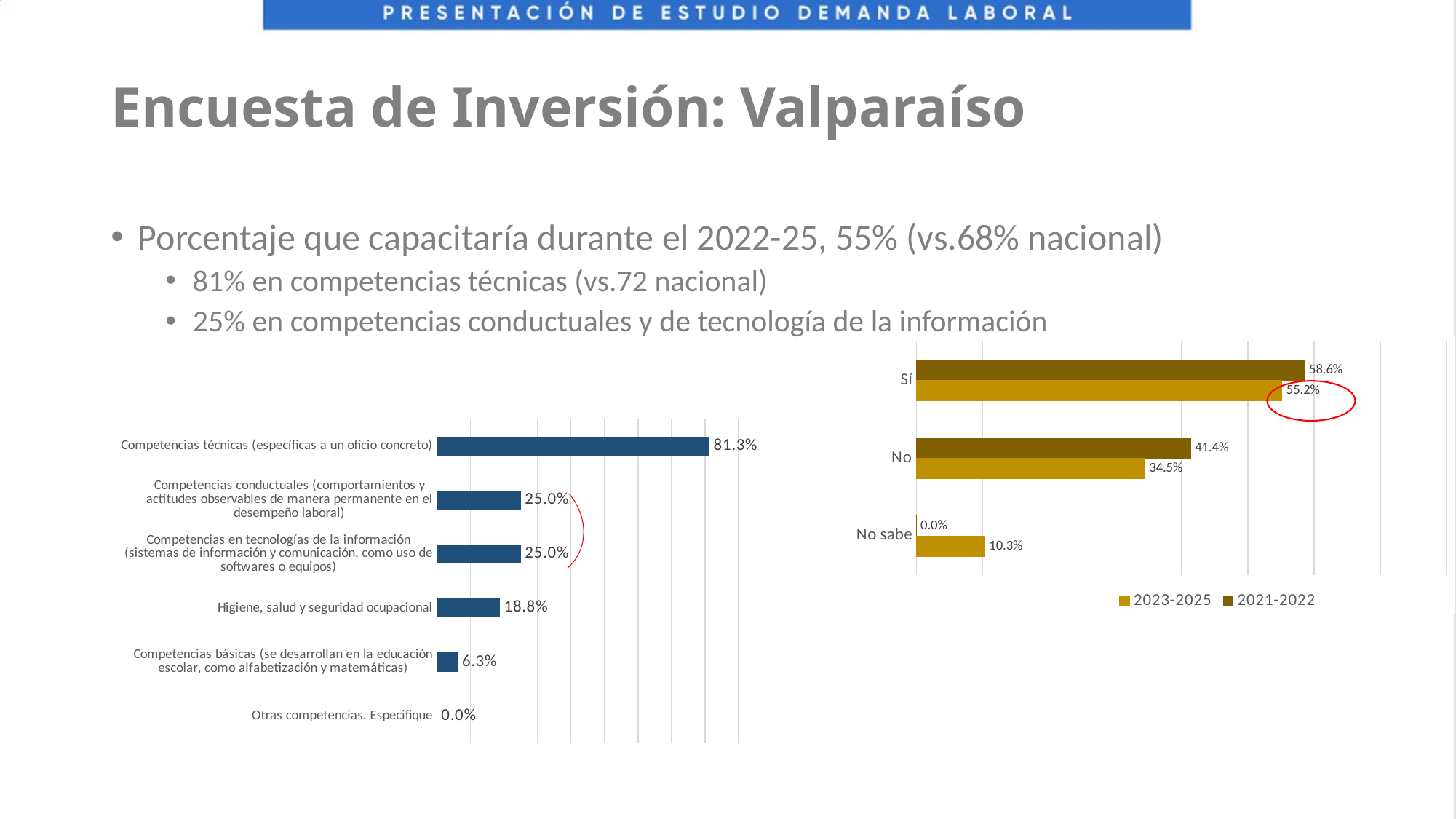
In the left chart, how many categories are shown? 6 In the right chart, which is larger for Sí: 2023-2025 or 2021-2022? 2021-2022 In the left chart, what is the difference between Competencias técnicas and Competencias básicas? 75.0% In the right chart, what is the value for Sí in the 2021-2022 series? 58.6% In the right chart, what is the value for No sabe in the 2023-2025 series? 10.3% What kind of chart is the left chart? Bar chart In the left chart, what is the value for Higiene, salud y seguridad ocupacional? 18.8% How many series does the legend of the right chart list? 2 In the left chart, which category has the highest value? Competencias técnicas (específicas a un oficio concreto) In the left chart, what is the value for Competencias técnicas (específicas a un oficio concreto)? 81.3% In the right chart, what is the difference between the 2021-2022 and 2023-2025 values for No? 6.9% In the left chart, which category has the lowest value? Otras competencias. Especifique